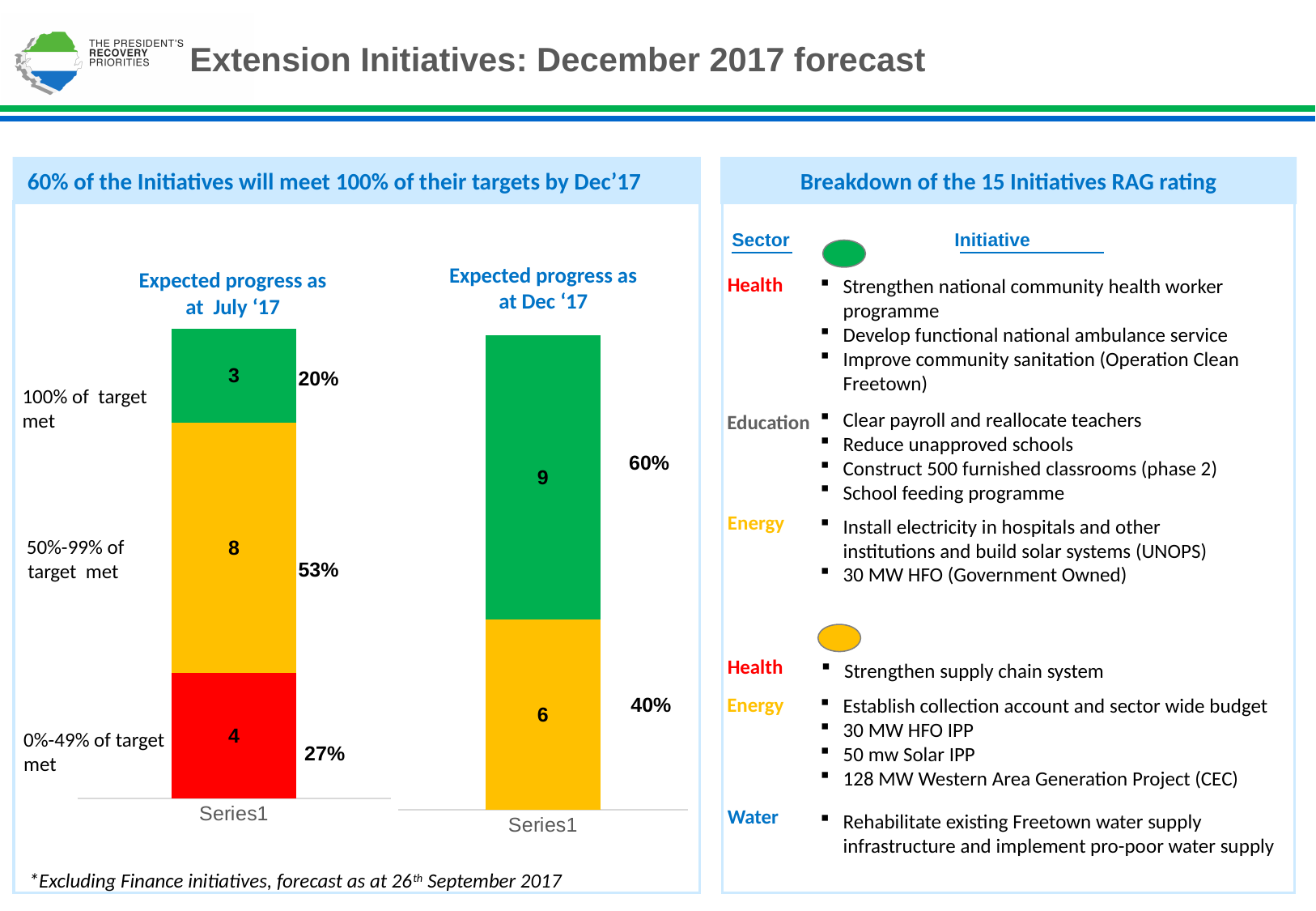
In the 'Expected progress as at July '17' chart, how many initiatives are in the '50%-99% of target met' segment? 8 What is the total number of initiatives in the 'Expected progress as at Dec '17' stacked bar? 15 In the 'Expected progress as at July '17' chart, which segment has the smallest number of initiatives? 100% of target met In the 'Expected progress as at Dec '17' chart, what percentage is shown for the amber (50%-99% of target met) segment? 40% In the 'Expected progress as at July '17' chart, what percentage is shown for the '0%-49% of target met' segment? 27% In the 'Expected progress as at Dec '17' chart, how many initiatives are in the green (100% of target met) segment? 9 Which is larger: the amber segment in the July '17 chart or the amber segment in the Dec '17 chart? July '17 How many segments does the 'Expected progress as at Dec '17' stacked bar contain? 2 What is the difference between the number of initiatives meeting 100% of target in the Dec '17 chart and in the July '17 chart? 6 What type of chart is used to show the expected progress as at July '17? Stacked bar chart In the 'Expected progress as at July '17' chart, which segment has the largest number of initiatives? 50%-99% of target met In the 'Expected progress as at July '17' chart, how many initiatives are in the '100% of target met' segment? 3